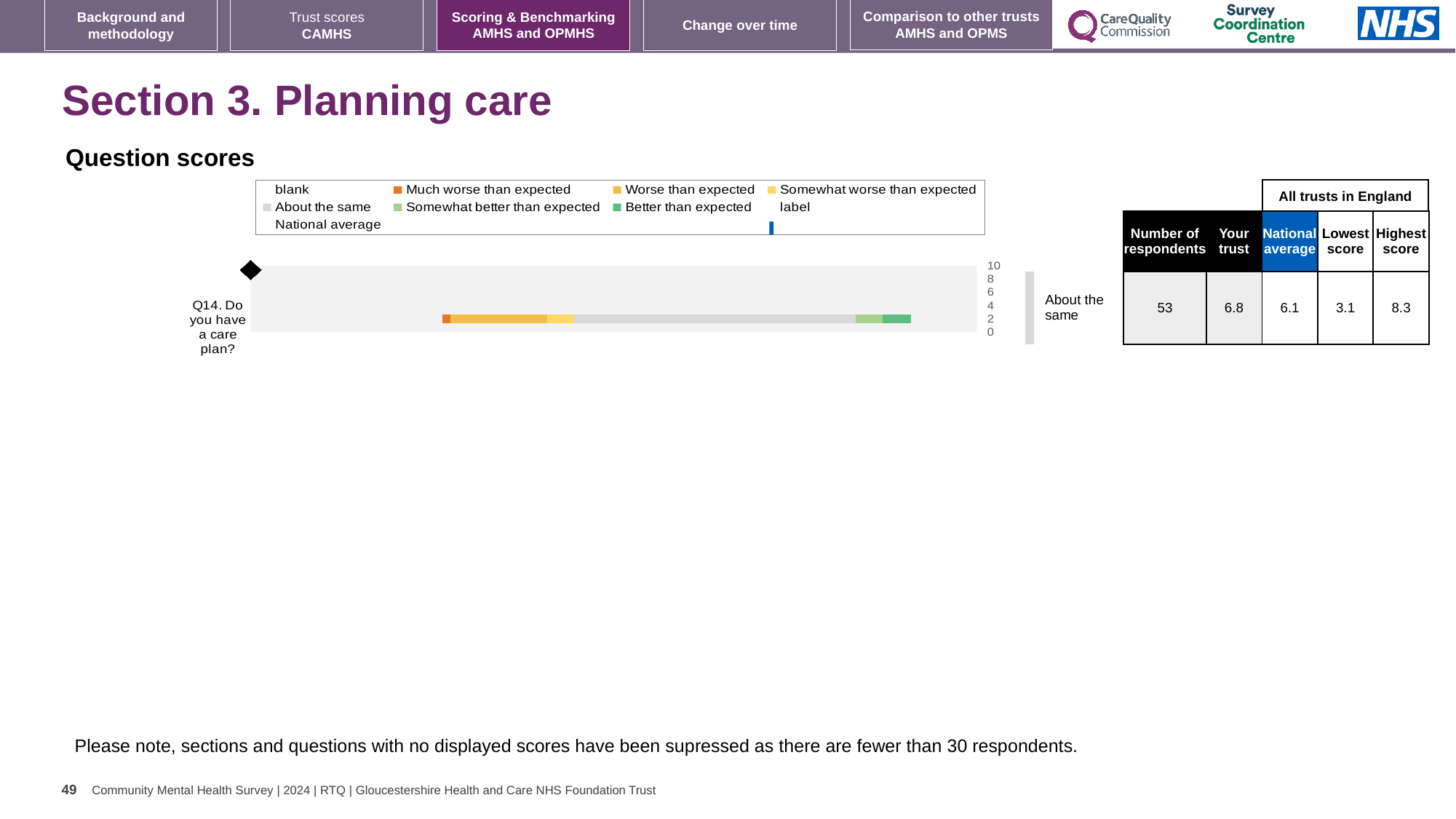
In the table beside the chart, what is the lowest score among all trusts in England for Q14? 3.1 Is the 'Your trust' score for Q14 larger or smaller than the national average? larger What is the highest value shown on the axis of the Question scores chart? 10 In the table beside the chart, what is the 'Your trust' score for Q14? 6.8 How many questions are plotted in the Question scores chart? 1 What benchmark category is shown next to the bar for Q14? About the same What is the difference between the highest score and the lowest score for Q14 in the table? 5.2 In the table beside the chart, what is the number of respondents for Q14? 53 Which question is plotted in the Question scores chart? Q14. Do you have a care plan? What kind of chart is shown under 'Question scores'? bar chart In the table beside the chart, what is the highest score among all trusts in England for Q14? 8.3 In the table beside the chart, what is the national average for Q14? 6.1